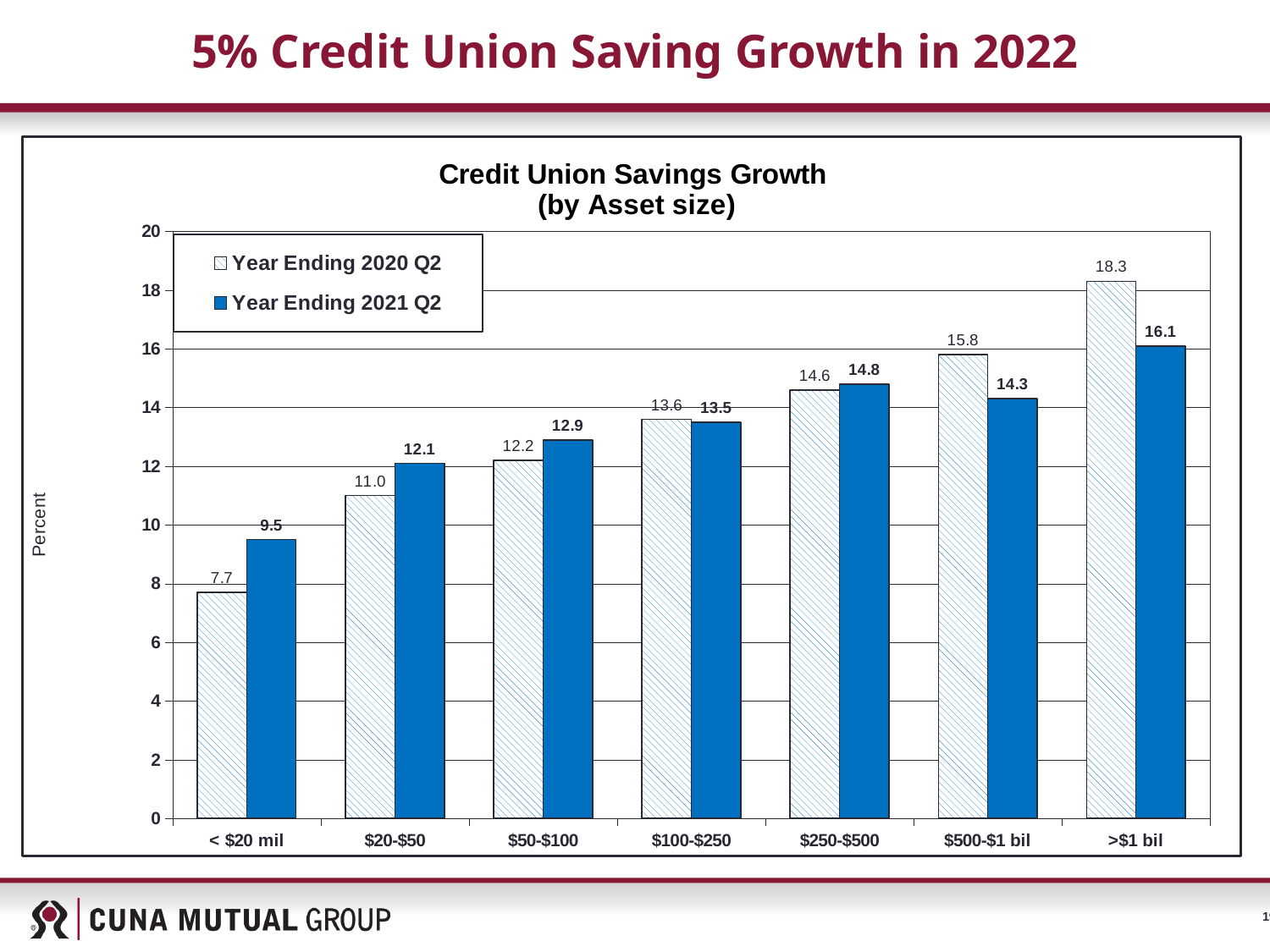
How many series does the legend list? 2 What is the Year Ending 2021 Q2 value for the $250-$500 category? 14.8 What is the Year Ending 2021 Q2 value for the $20-$50 asset size category? 12.1 What kind of chart is shown on the slide? Bar chart For the $500-$1 bil category, which series has the larger value: Year Ending 2020 Q2 or Year Ending 2021 Q2? Year Ending 2020 Q2 What is the Year Ending 2020 Q2 value for the >$1 bil asset size category? 18.3 Which asset size category has the highest Year Ending 2021 Q2 value? >$1 bil Do the Year Ending 2020 Q2 values rise or fall as asset size increases along the x axis? Rise Which asset size category has the lowest Year Ending 2020 Q2 value? < $20 mil What is the difference between the Year Ending 2021 Q2 and Year Ending 2020 Q2 values for the < $20 mil category? 1.8 What is the title of the chart? Credit Union Savings Growth (by Asset size) How many asset size categories are shown on the x axis? 7